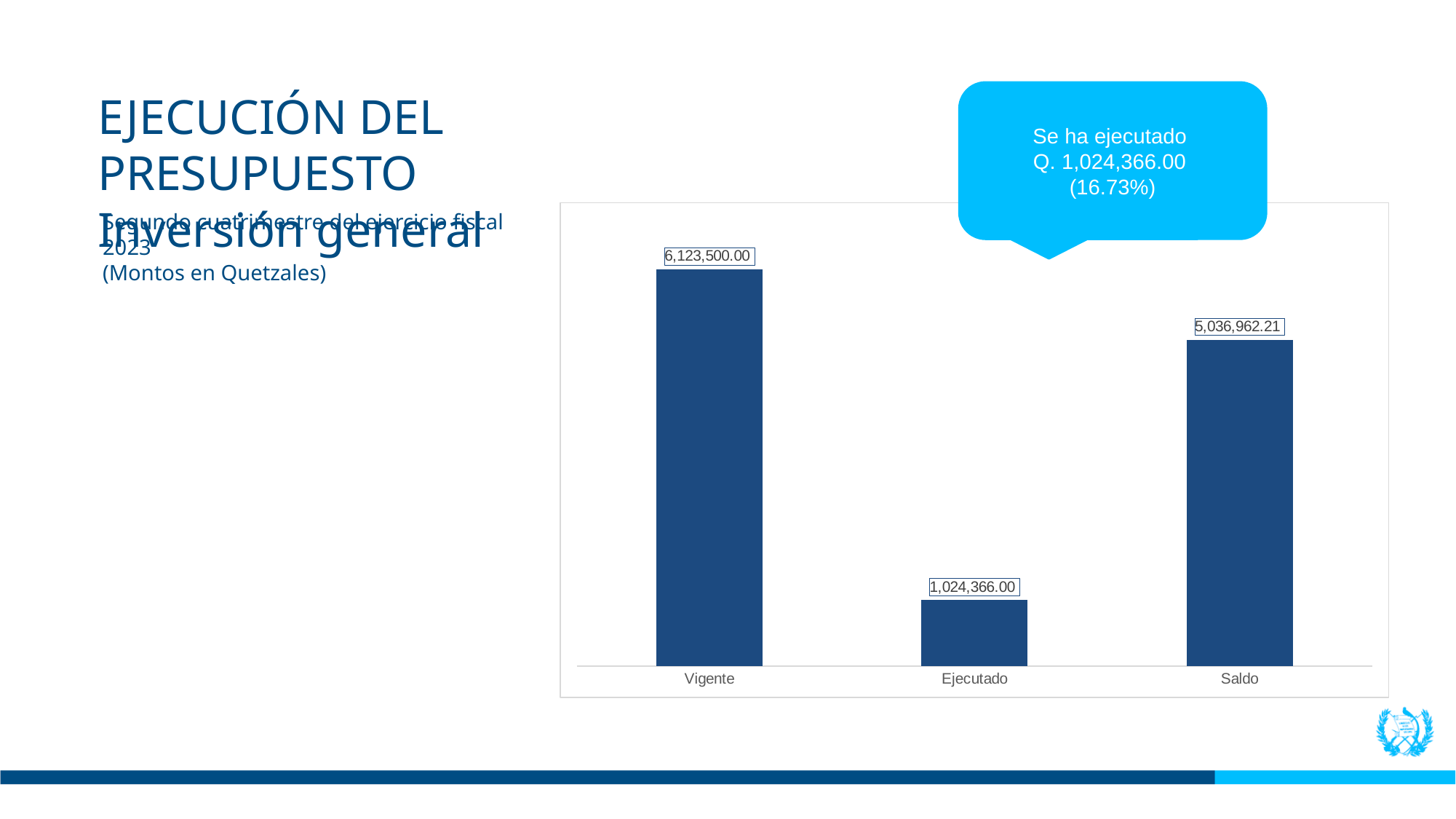
What is the value of the Saldo bar? 5,036,962.21 What percentage of execution does the callout on the slide state? 16.73% What kind of chart is shown on the slide? Bar chart What is the difference between the Vigente and Ejecutado values? 5,099,134.00 How many categories are shown on the x axis of the chart? 3 What is the difference between the Vigente and Saldo values? 1,086,537.79 What is the difference between the Saldo and Ejecutado values? 4,012,596.21 What is the value of the Ejecutado bar? 1,024,366.00 Which is larger, the Saldo value or the Ejecutado value? Saldo What is the value of the Vigente bar? 6,123,500.00 Which category has the highest value? Vigente Which category has the lowest value? Ejecutado